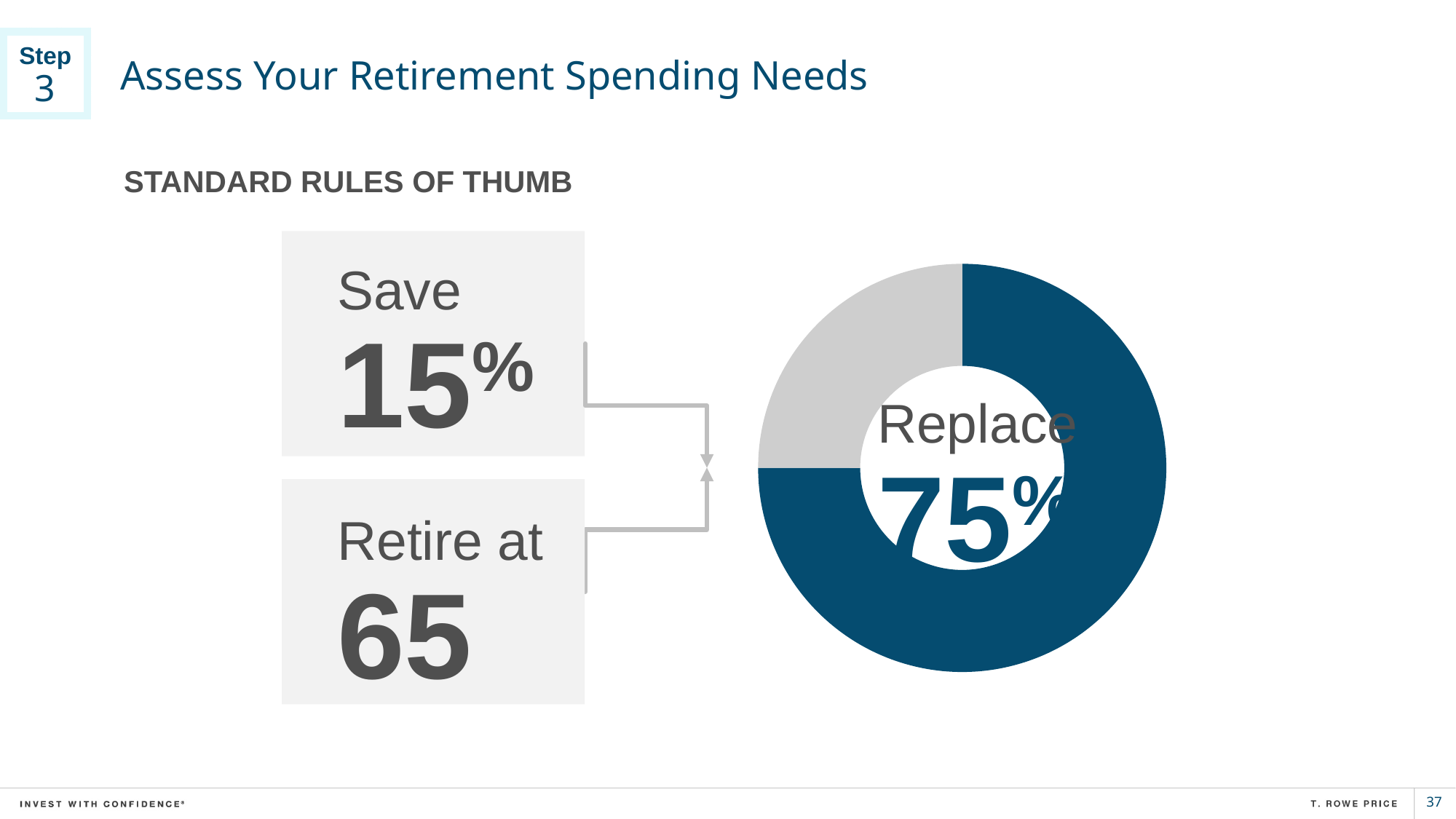
Is the blue slice of the donut chart greater or less than 50% of the whole? greater What word appears above the percentage in the center of the donut chart? Replace How many slices does the donut chart have? 2 What kind of chart is shown on the slide? doughnut chart What share of the donut chart does the gray slice represent? 25% What colour is the slice representing the 75% 'Replace' value? blue What percentage is labeled in the center of the donut chart? 75% Which slice of the donut chart is larger, the blue one or the gray one? the blue one